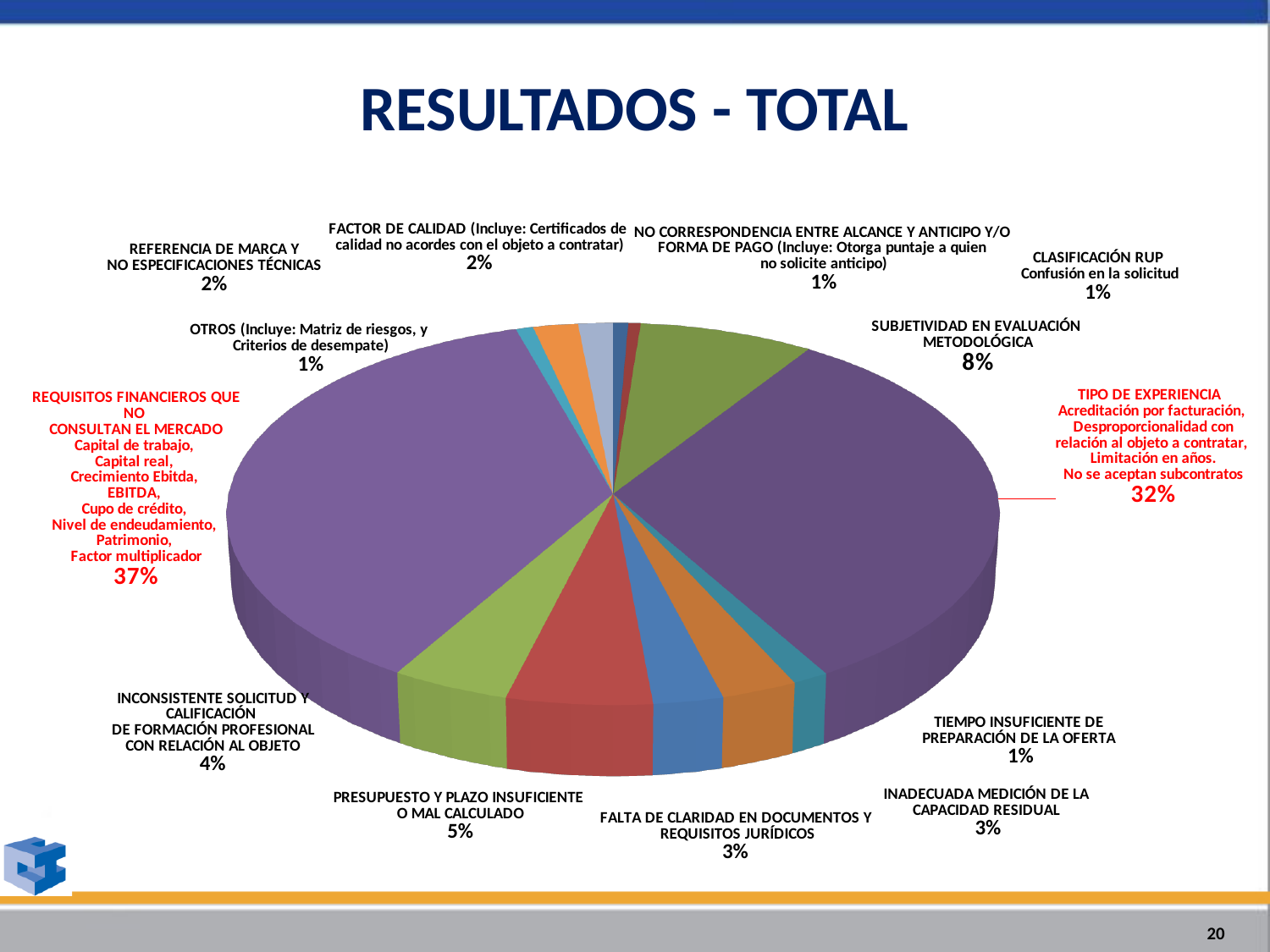
Which is larger: the share for SUBJETIVIDAD EN EVALUACIÓN METODOLÓGICA or the share for INCONSISTENTE SOLICITUD Y CALIFICACIÓN DE FORMACIÓN PROFESIONAL CON RELACIÓN AL OBJETO? SUBJETIVIDAD EN EVALUACIÓN METODOLÓGICA What share of the pie does TIPO DE EXPERIENCIA represent? 32% What percentage is shown for INADECUADA MEDICIÓN DE LA CAPACIDAD RESIDUAL? 3% What is the difference in percentage points between REQUISITOS FINANCIEROS QUE NO CONSULTAN EL MERCADO and TIPO DE EXPERIENCIA? 5 percentage points What kind of chart is shown on the slide? Pie chart What percentage is shown for SUBJETIVIDAD EN EVALUACIÓN METODOLÓGICA? 8% What percentage is shown for PRESUPUESTO Y PLAZO INSUFICIENTE O MAL CALCULADO? 5% What is the title of the chart on the slide? RESULTADOS - TOTAL Which category has the largest share of the pie? REQUISITOS FINANCIEROS QUE NO CONSULTAN EL MERCADO How many categories are shown in the pie chart? 13 What percentage is shown for TIEMPO INSUFICIENTE DE PREPARACIÓN DE LA OFERTA? 1% What share of the pie does REQUISITOS FINANCIEROS QUE NO CONSULTAN EL MERCADO represent? 37%